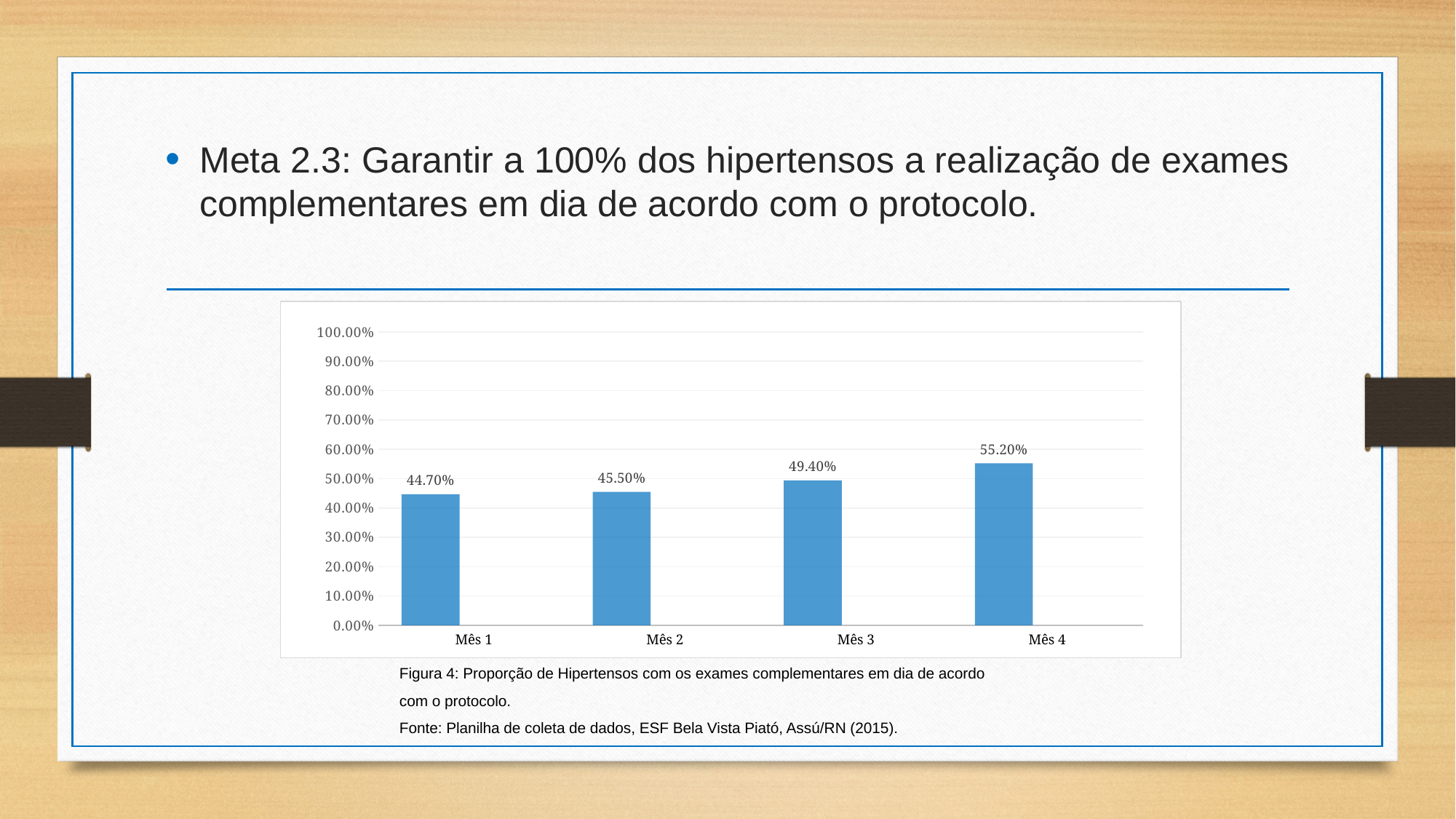
What is the value for Mês 4? 55.20% Which month has the highest value? Mês 4 Which is larger, the value for Mês 2 or the value for Mês 3? Mês 3 What is the value for Mês 1? 44.70% Is the value for Mês 4 greater or less than 50.00%? greater What is the value for Mês 3? 49.40% What is the difference between the values for Mês 3 and Mês 2? 3.90% Which month has the lowest value? Mês 1 What kind of chart is shown on the slide? bar chart What is the difference between the values for Mês 4 and Mês 1? 10.50% Do the values rise or fall from Mês 1 to Mês 4? rise How many months are shown on the x axis? 4